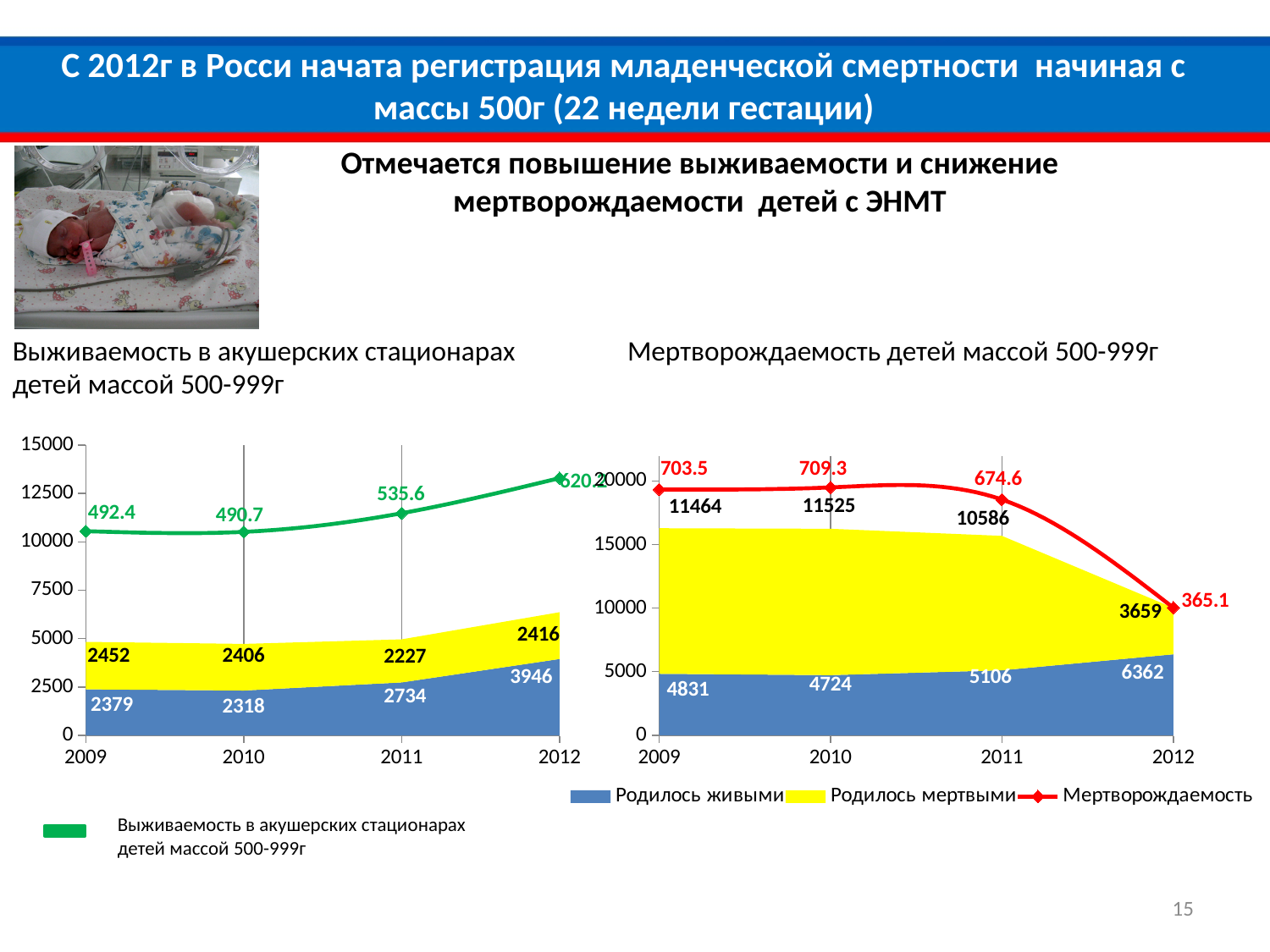
In the chart 'Мертворождаемость детей массой 500-999г', what is the 'Мертворождаемость' value for 2010? 709.3 In the chart 'Мертворождаемость детей массой 500-999г', what is the value of 'Родилось мертвыми' in 2011? 10586 In the left chart 'Выживаемость в акушерских стационарах детей массой 500-999г', what is the value of the blue area in 2012? 3946 In the chart 'Мертворождаемость детей массой 500-999г', does 'Мертворождаемость' rise or fall from 2011 to 2012? fall In the left chart 'Выживаемость в акушерских стационарах детей массой 500-999г', what is the value of the green line in 2011? 535.6 In the left chart 'Выживаемость в акушерских стационарах детей массой 500-999г', how many years are shown on the x axis? 4 In the chart 'Мертворождаемость детей массой 500-999г', what is the value of 'Родилось живыми' in 2012? 6362 In the chart 'Мертворождаемость детей массой 500-999г', what is the difference between the 'Родилось мертвыми' values for 2011 and 2012? 6927 In the chart 'Мертворождаемость детей массой 500-999г', in which year is 'Мертворождаемость' lowest? 2012 In the chart 'Мертворождаемость детей массой 500-999г', how many series does the legend list? 3 In the chart 'Мертворождаемость детей массой 500-999г', in which year is 'Родилось мертвыми' highest? 2010 In the left chart 'Выживаемость в акушерских стационарах детей массой 500-999г', which is larger: the blue area value in 2009 or in 2012? 2012